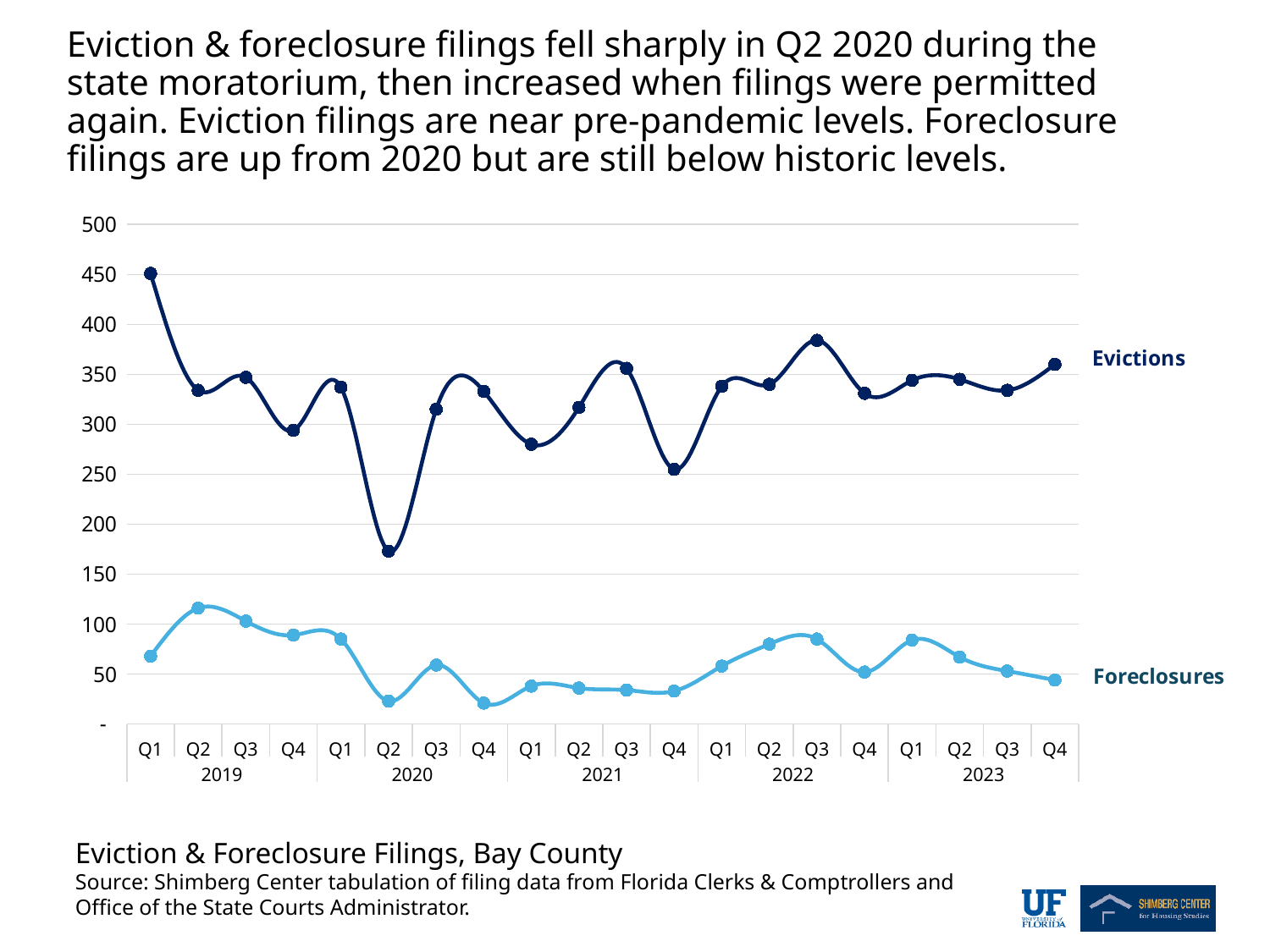
In which quarter is the Evictions line at its highest? Q1 2019 What is the title of the chart given below the plot? Eviction & Foreclosure Filings, Bay County Is the Evictions value for Q2 2020 greater or less than 200? less Is the Evictions value for Q1 2019 greater or less than 400? greater Which is higher for Evictions: Q3 2022 or Q4 2022? Q3 2022 In which quarter is the Foreclosures line at its highest? Q2 2019 Is the Foreclosures value for Q2 2019 greater or less than 100? greater What kind of chart is shown on the slide? Line chart In which quarter is the Evictions line at its lowest? Q2 2020 How many series are plotted on the chart? 2 How many quarterly data points does each line have? 20 Do Evictions rise or fall from Q1 2019 to Q2 2020? Fall